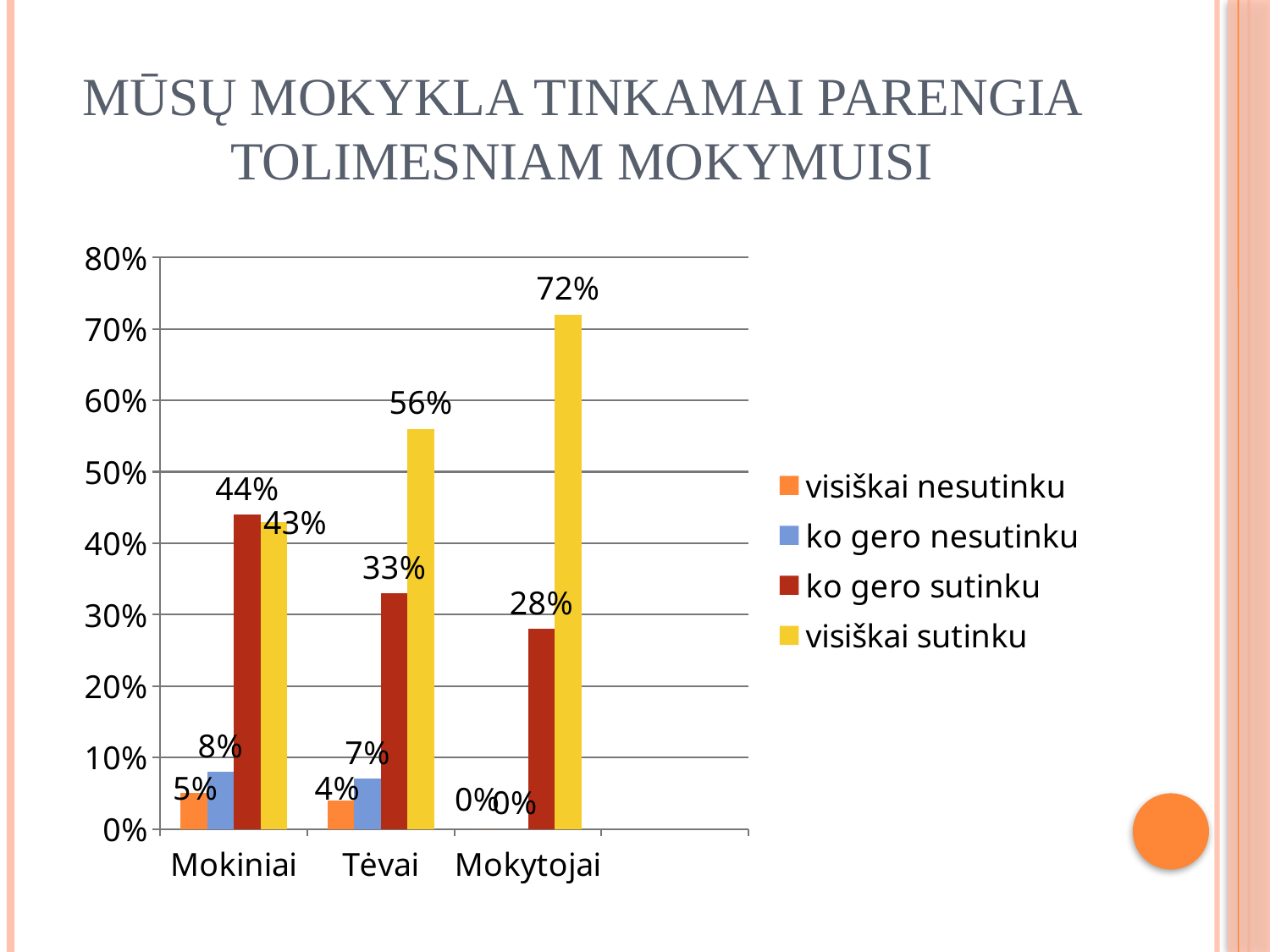
Which category has the lowest value for 'ko gero sutinku'? Mokytojai What kind of chart is shown on the slide? bar chart What is the value for 'visiškai sutinku' for Mokytojai? 72% What is the value for 'visiškai nesutinku' for Tėvai? 4% How many categories are shown on the x axis? 3 What is the value for 'ko gero nesutinku' for Mokiniai? 8% Which is larger for Tėvai: 'ko gero sutinku' or 'visiškai sutinku'? visiškai sutinku What is the difference between the 'visiškai sutinku' values for Mokytojai and Tėvai? 16% Which category has the highest value for 'visiškai sutinku'? Mokytojai Which series is shown in yellow in the legend? visiškai sutinku What is the value for 'ko gero sutinku' for Mokiniai? 44% How many series does the legend list? 4